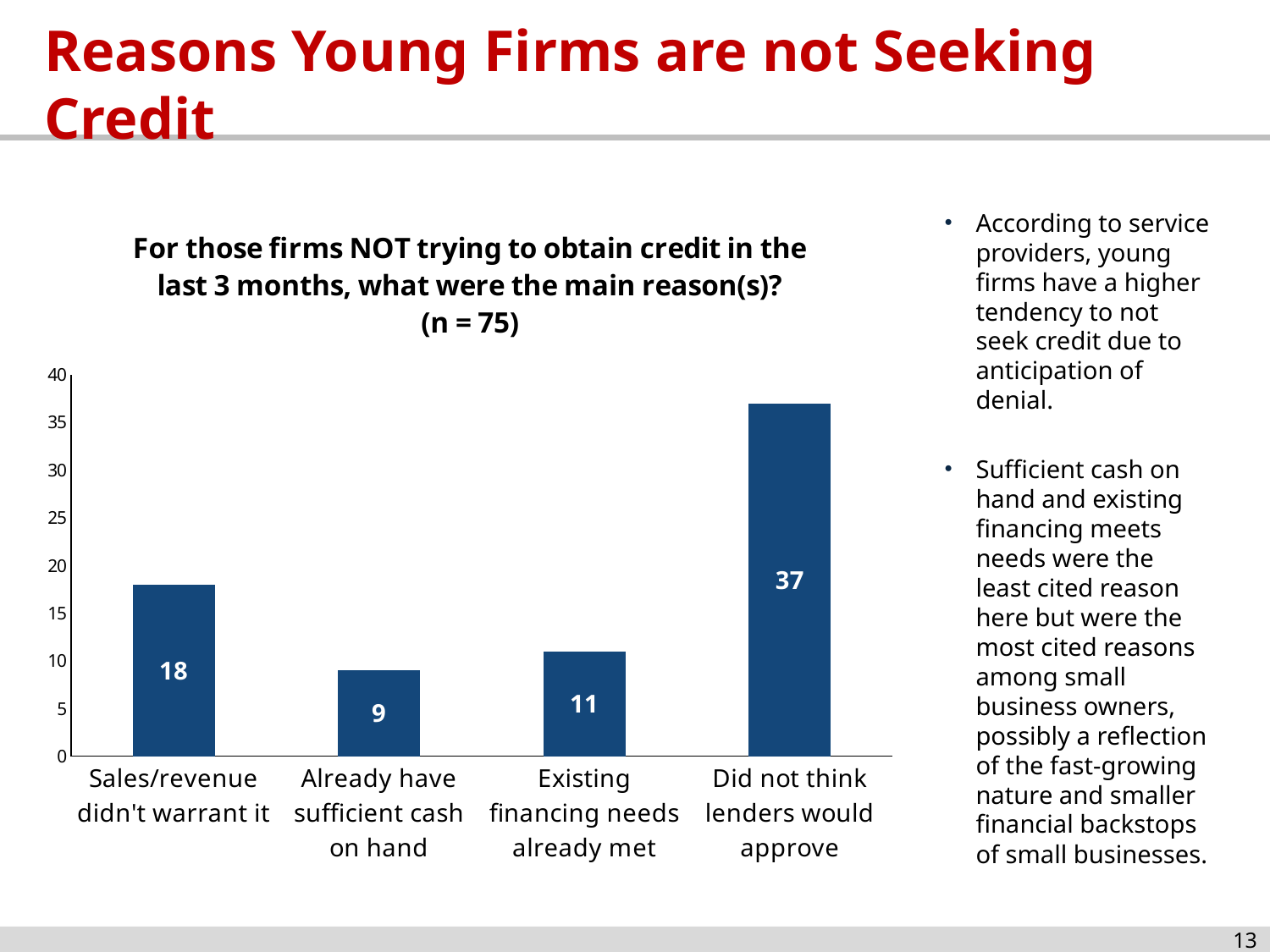
What is the difference between the values for "Did not think lenders would approve" and "Sales/revenue didn't warrant it"? 19 Which is larger: the value for "Sales/revenue didn't warrant it" or the value for "Existing financing needs already met"? Sales/revenue didn't warrant it What is the value for "Sales/revenue didn't warrant it"? 18 Is the value for "Did not think lenders would approve" greater or less than 35? greater Which reason has the highest value? Did not think lenders would approve What is the difference between the values for "Existing financing needs already met" and "Already have sufficient cash on hand"? 2 What is the sample size (n) stated in the chart title? 75 Which reason has the lowest value? Already have sufficient cash on hand What is the value for "Did not think lenders would approve"? 37 What kind of chart is shown on the slide? bar chart How many reasons (categories) are shown on the chart? 4 What is the value for "Already have sufficient cash on hand"? 9